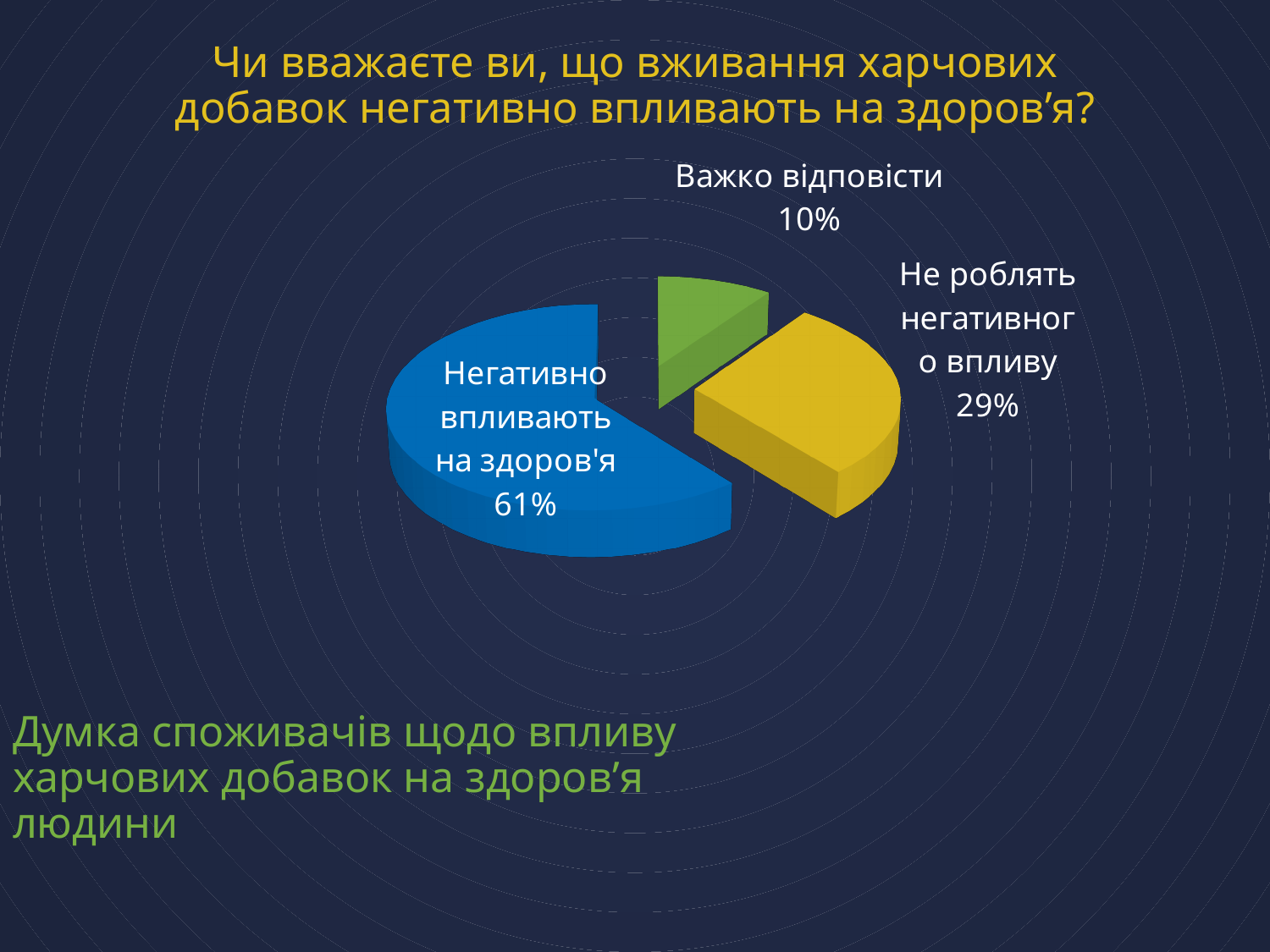
What is the difference in percentage points between "Не роблять негативного впливу" and "Важко відповісти"? 19 What is the difference in percentage points between "Негативно впливають на здоров'я" and "Не роблять негативного впливу"? 32 Which slice of the pie is the largest? Негативно впливають на здоров'я Which slice of the pie is the smallest? Важко відповісти What share of the pie is labelled "Негативно впливають на здоров'я"? 61% What share of the pie is labelled "Важко відповісти"? 10% Which is larger: the share for "Не роблять негативного впливу" or the share for "Важко відповісти"? Не роблять негативного впливу What share of the pie is labelled "Не роблять негативного впливу"? 29% What colour is the slice labelled "Важко відповісти"? Green How many slices does the pie chart have? 3 What colour is the slice labelled "Негативно впливають на здоров'я"? Blue What kind of chart is shown on the slide? Pie chart